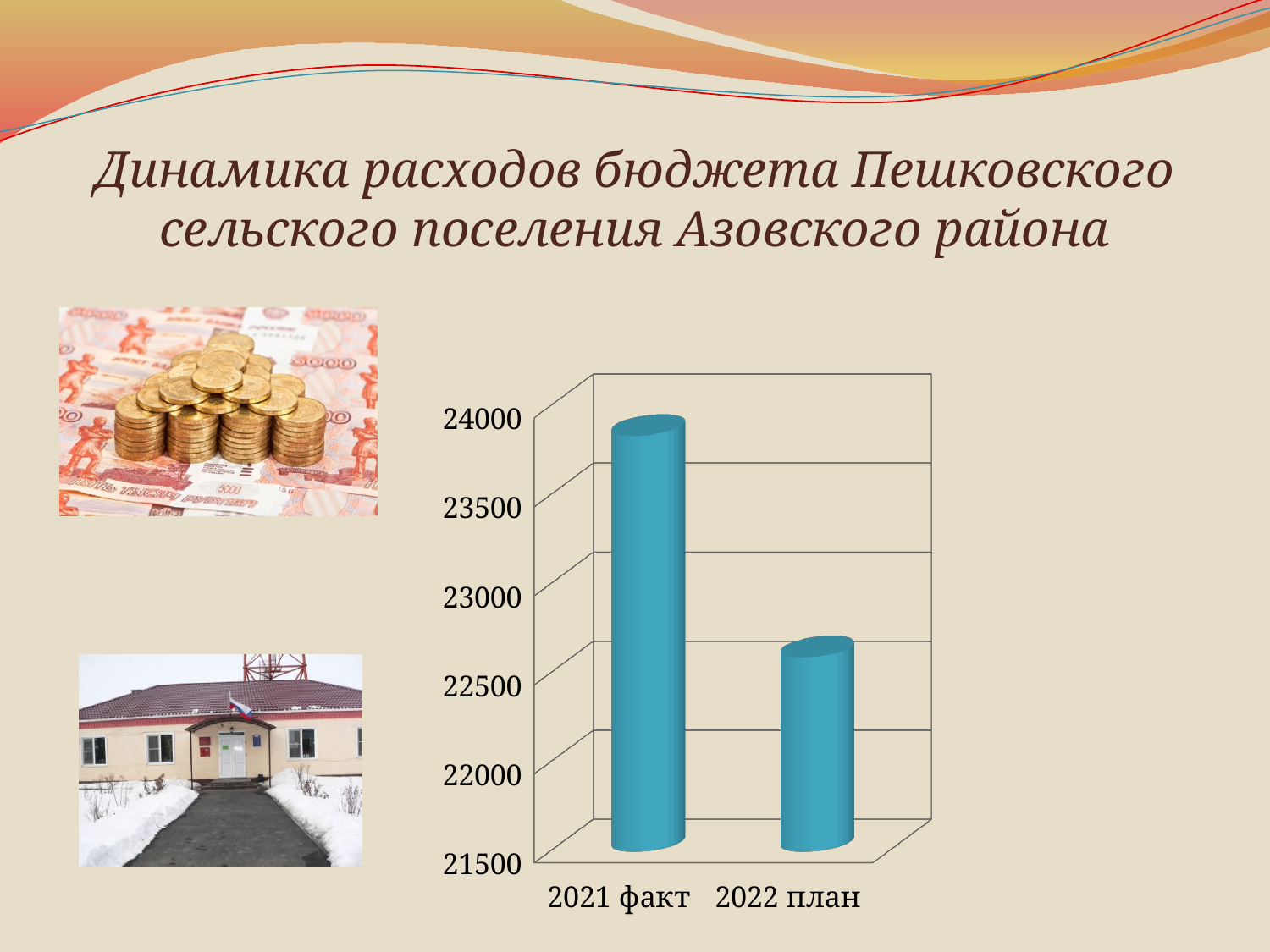
Is the value for 2022 план greater or less than 23500? less How many categories are plotted on the chart? 2 What colour are the bars on the chart? blue Is the value for 2021 факт greater or less than 23000? greater Is the value for 2021 факт greater or less than 23500? greater Do the values rise or fall from 2021 факт to 2022 план? fall Which is larger, the value for 2021 факт or the value for 2022 план? 2021 факт What kind of chart is shown on the slide? bar chart What is the title of the slide containing the chart? Динамика расходов бюджета Пешковского сельского поселения Азовского района Which category has the lowest value on the chart? 2022 план Which category has the highest value on the chart? 2021 факт